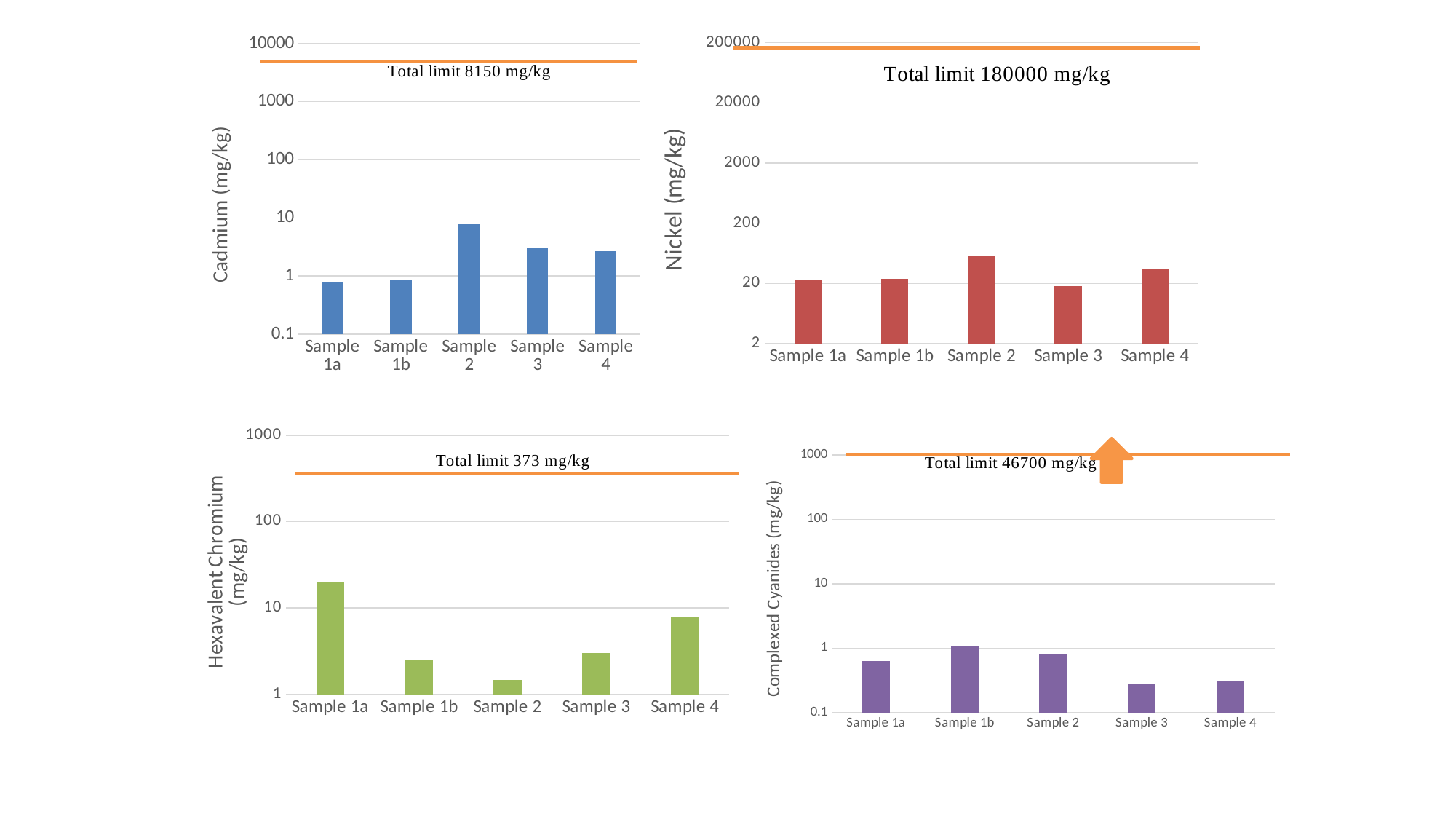
In the Hexavalent Chromium chart, which sample has the lowest value? Sample 2 In the Complexed Cyanides chart, which sample has the highest value? Sample 1b In the Hexavalent Chromium chart, which sample has the highest value? Sample 1a In the Nickel chart, is the value for Sample 2 greater or less than 20? greater In the Cadmium chart, is the value for Sample 1a greater or less than 1? less In the Nickel chart, which sample has the highest value? Sample 2 What total limit is stated on the Hexavalent Chromium chart? 373 mg/kg How many samples are shown on the x axis of the Nickel chart? 5 In the Cadmium chart, is the value for Sample 2 greater or less than 1? greater